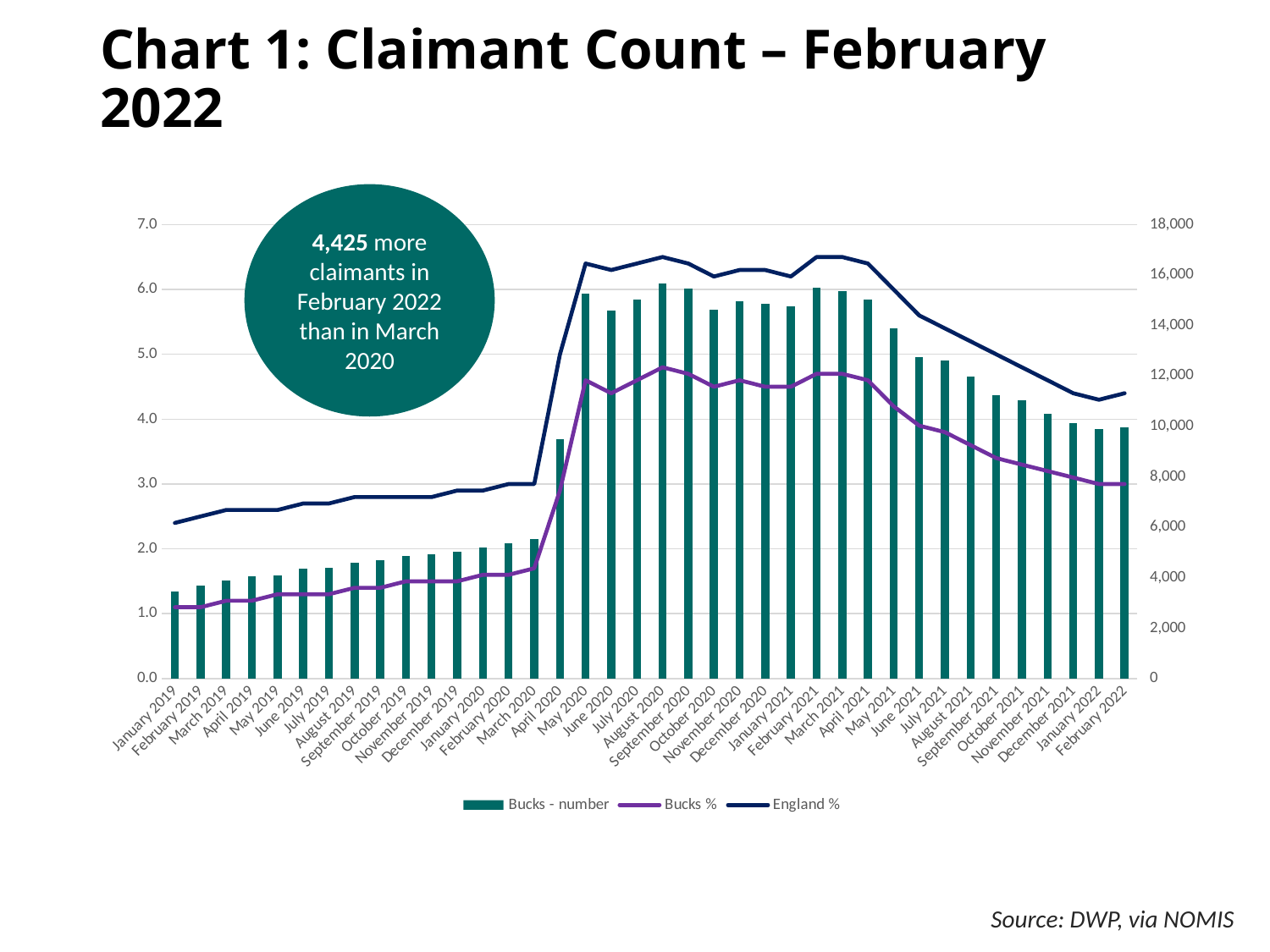
Which month has the lowest value for England %? January 2019 How many months are shown along the x axis? 38 Is the value for Bucks % in August 2020 greater or less than 4.0? greater How many series does the legend list? 3 What kind of chart is this? Combined bar and line chart Is the value for England % in May 2020 greater or less than 6.0? greater Which is larger in May 2020, Bucks % or England %? England % According to the callout on the chart, how many more claimants were there in February 2022 than in March 2020? 4,425 Is the value for Bucks - number in May 2020 greater or less than 14,000? greater Does Bucks - number rise or fall from May 2021 to February 2022? fall Which month has the lowest value for Bucks - number? January 2019